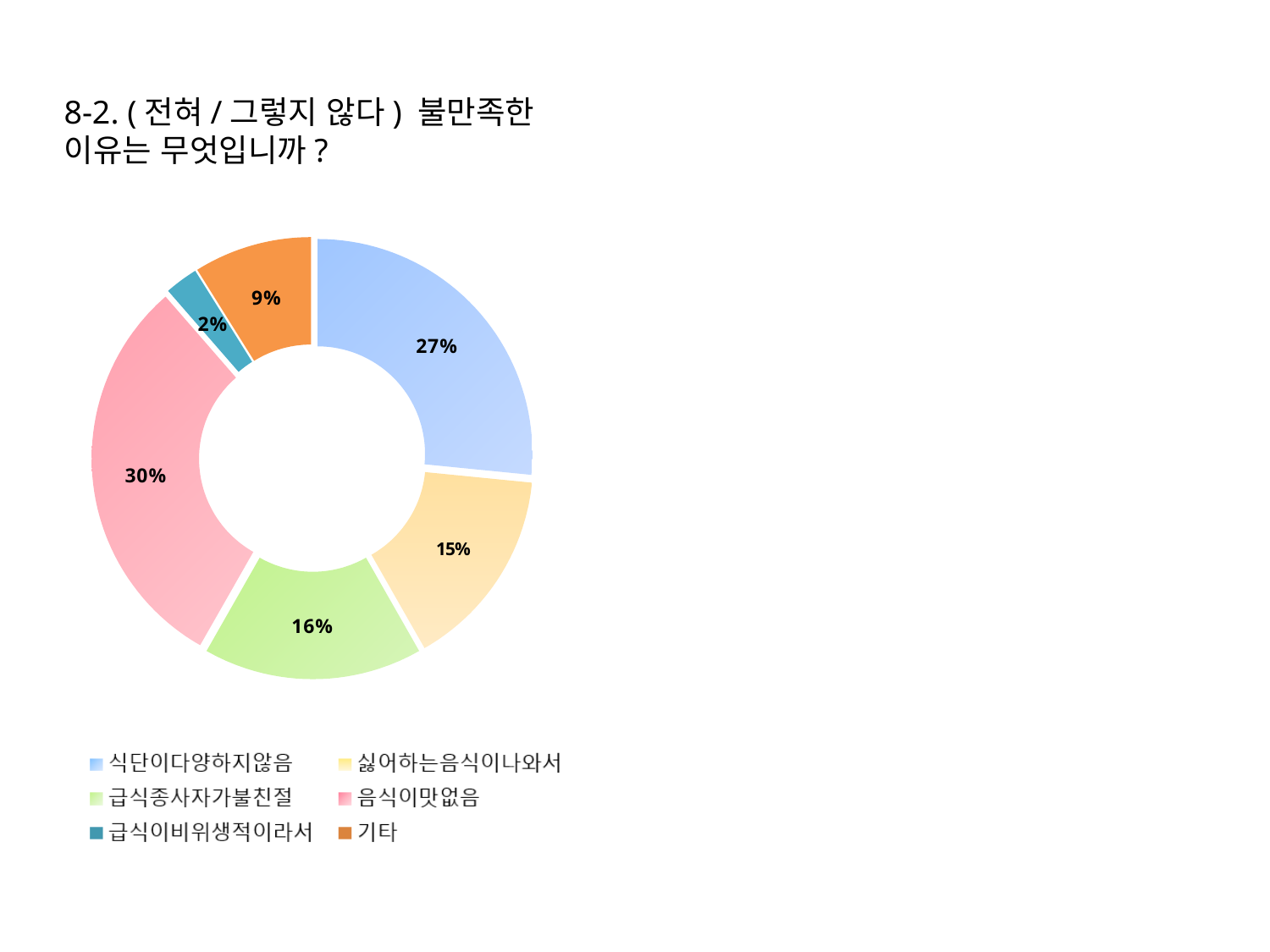
What kind of chart is shown on the slide? Doughnut chart What percentage is shown for 음식이맛없음? 30% What percentage is shown for 기타? 9% What colour is the slice for 음식이맛없음? Pink What is the difference in percentage points between 음식이맛없음 and 식단이다양하지않음? 3 Which is larger, the share for 급식종사자가불친절 or the share for 싫어하는음식이나와서? 급식종사자가불친절 What is the combined share of 기타 and 급식이비위생적이라서? 11% What percentage is shown for 급식이비위생적이라서? 2% What percentage is shown for 식단이다양하지않음? 27% Which category has the smallest share of the chart? 급식이비위생적이라서 Which category has the largest share of the chart? 음식이맛없음 How many categories are shown in the chart? 6